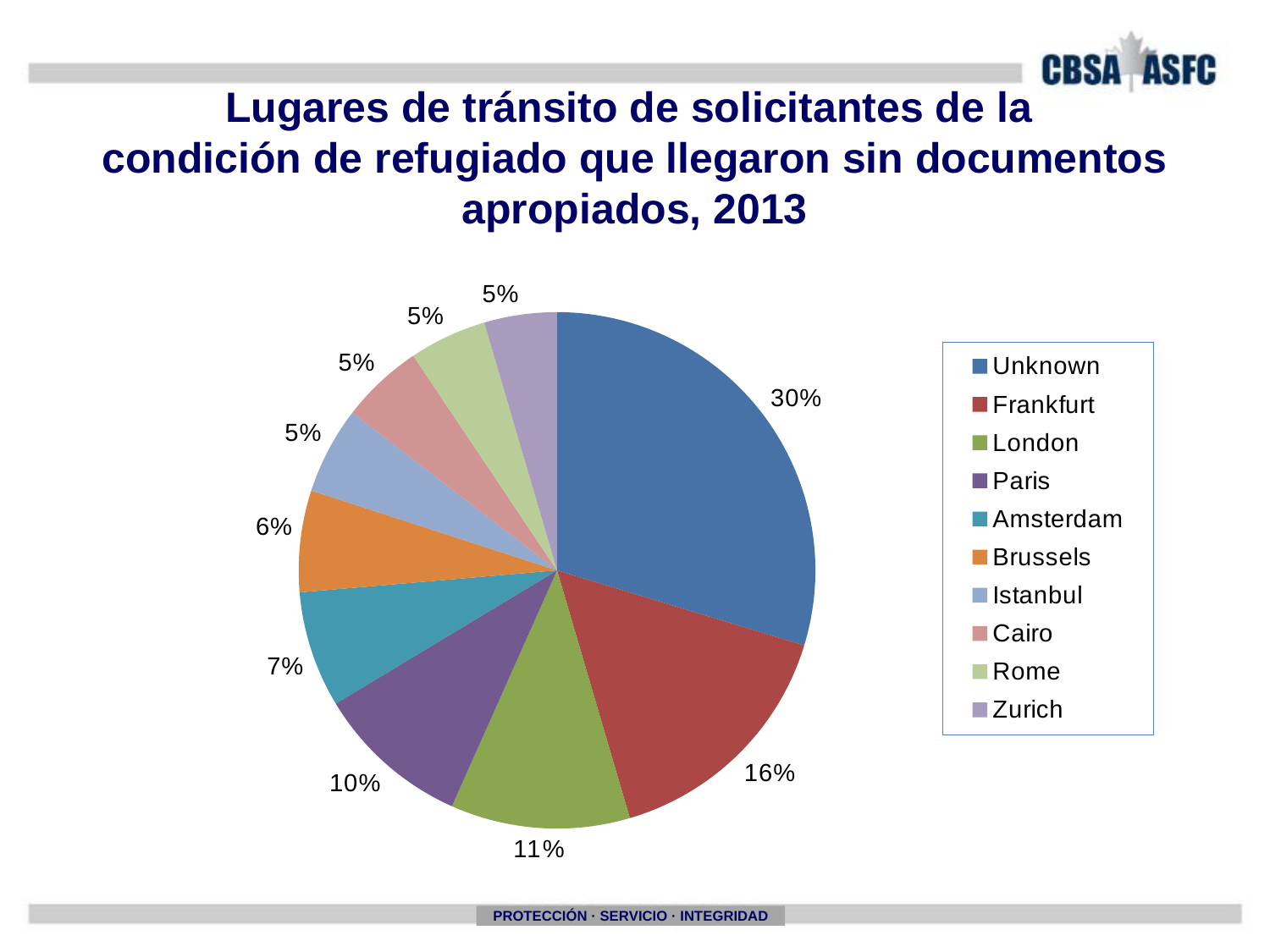
What share of the pie does Unknown represent? 30% What is the value shown for Amsterdam? 7% What is the difference between the Unknown slice and the Frankfurt slice? 14% What is the value shown for London? 11% What is the value shown for Paris? 10% What is the value shown for Brussels? 6% Which is larger, the slice for Paris or the slice for Amsterdam? Paris Which category has the largest slice of the pie? Unknown What is the value shown for Frankfurt? 16% What type of chart is shown on the slide? pie chart How many categories does the legend list? 10 What colour is the Brussels slice in the pie chart? orange